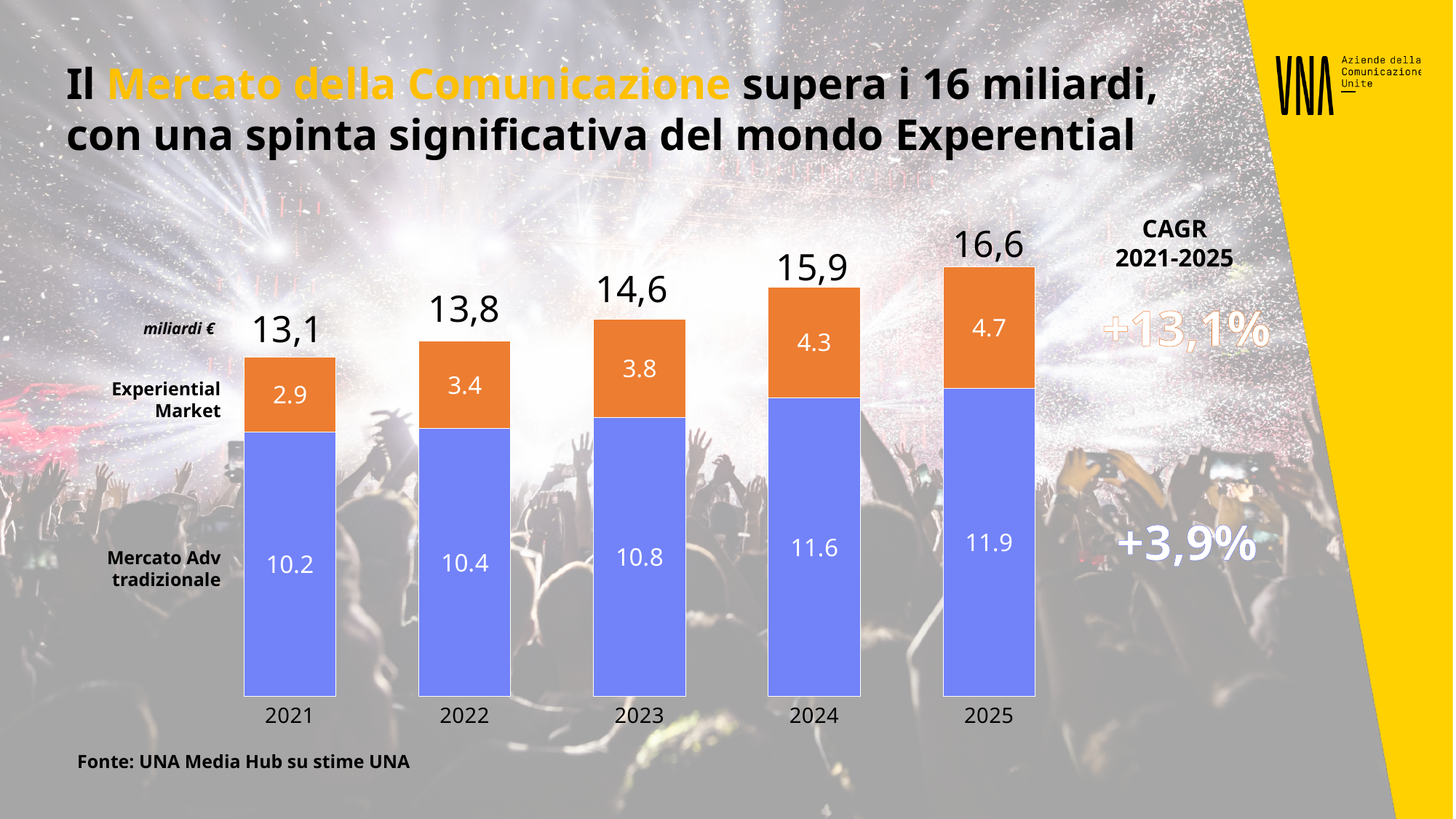
How many series are stacked in each bar? 2 What is the total printed above the bar for 2024? 15,9 Which year has the lowest Experiential Market value? 2021 Which year has the highest total value? 2025 What kind of chart is shown on the slide? Stacked bar chart Which is larger, the Experiential Market value for 2022 or for 2024? 2024 How many years are shown on the x axis? 5 Do the total values rise or fall from 2021 to 2025? Rise What is the value of the Experiential Market segment for 2023? 3.8 What is the difference between the Mercato Adv tradizionale values for 2024 and 2021? 1.4 What is the value of the Mercato Adv tradizionale segment for 2025? 11.9 What is the CAGR 2021-2025 shown for the Experiential Market? +13,1%